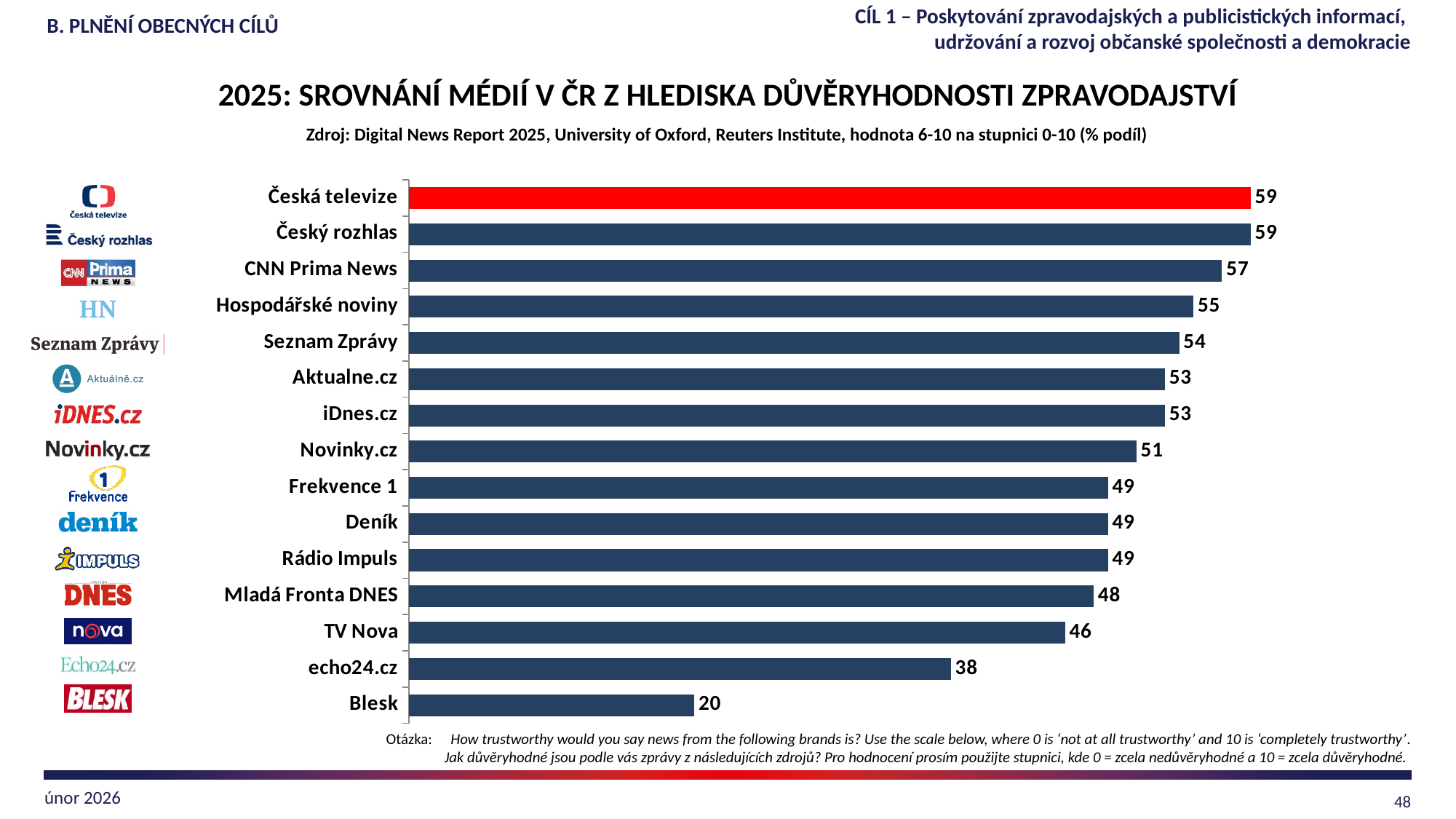
What kind of chart is shown on the slide? Bar chart What is the value for Blesk? 20 What is the difference between the values for Hospodářské noviny and Mladá Fronta DNES? 7 Which bar is shown in red rather than dark blue? Česká televize Which has a larger value, echo24.cz or Rádio Impuls? Rádio Impuls What is the value for TV Nova? 46 Which has a larger value, Seznam Zprávy or TV Nova? Seznam Zprávy What is the value for Novinky.cz? 51 What is the difference between the values for Česká televize and echo24.cz? 21 How many media are shown in the chart? 15 What is the value for CNN Prima News? 57 Which medium has the lowest value? Blesk